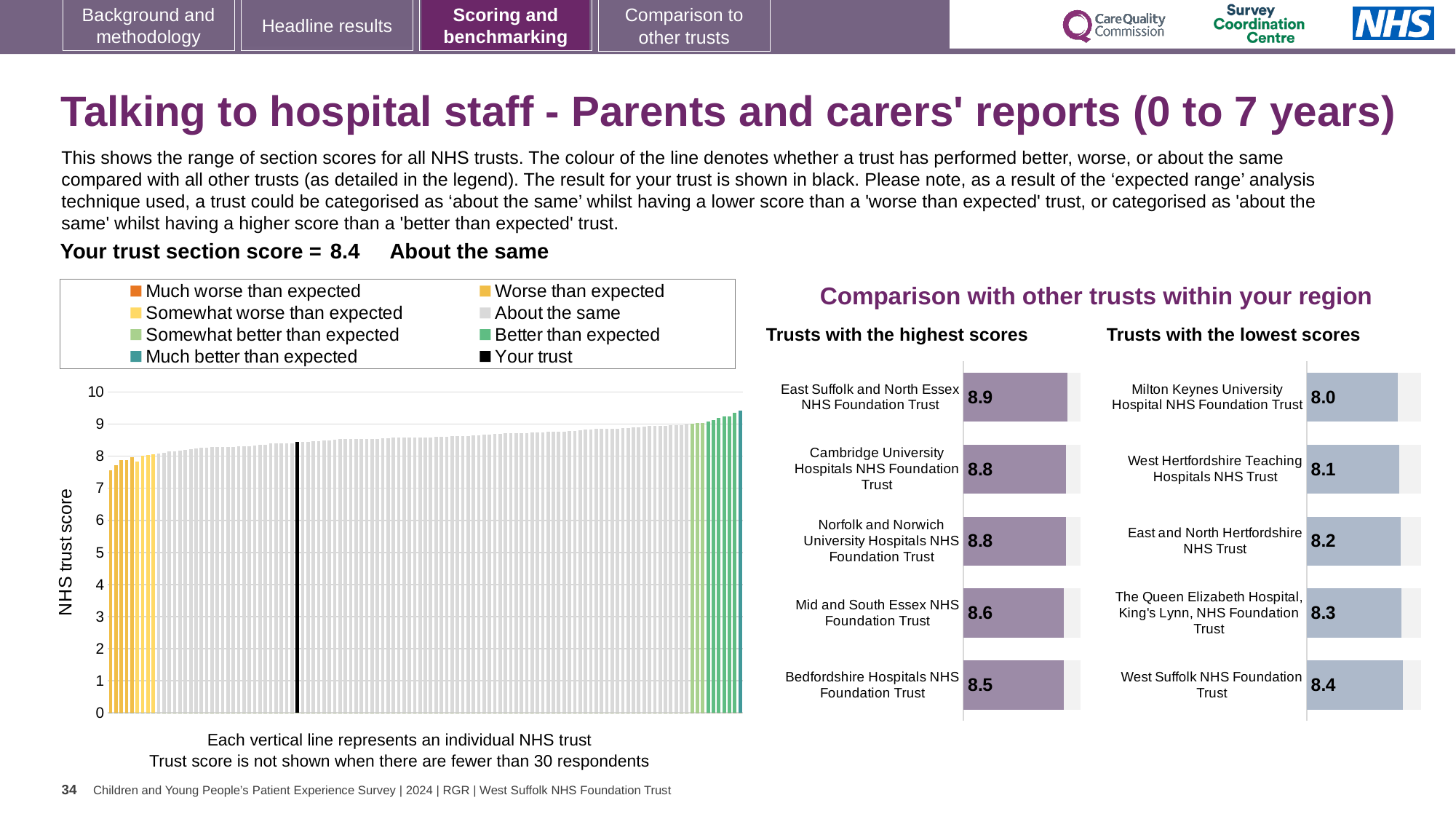
What kind of chart is the NHS trust score chart on the left? Bar chart In the 'Trusts with the lowest scores' chart, which has the larger score: West Hertfordshire Teaching Hospitals NHS Trust or West Suffolk NHS Foundation Trust? West Suffolk NHS Foundation Trust In the 'Trusts with the highest scores' chart, what is the score for East Suffolk and North Essex NHS Foundation Trust? 8.9 In the 'Trusts with the lowest scores' chart, what is the score for The Queen Elizabeth Hospital, King's Lynn, NHS Foundation Trust? 8.3 In the 'Trusts with the highest scores' chart, which trust has the highest score? East Suffolk and North Essex NHS Foundation Trust In the 'Trusts with the lowest scores' chart, what is the score for Milton Keynes University Hospital NHS Foundation Trust? 8.0 In the 'Trusts with the lowest scores' chart, which trust has the lowest score? Milton Keynes University Hospital NHS Foundation Trust In the NHS trust score chart on the left, is the value of the highest bar greater or less than 9? greater In the 'Trusts with the highest scores' chart, what is the difference between the scores of East Suffolk and North Essex NHS Foundation Trust and Bedfordshire Hospitals NHS Foundation Trust? 0.4 How many entries does the legend of the NHS trust score chart on the left list? 8 In the NHS trust score chart on the left, what is the section score for your trust (the black bar)? 8.4 How many trusts are shown in the 'Trusts with the lowest scores' chart? 5